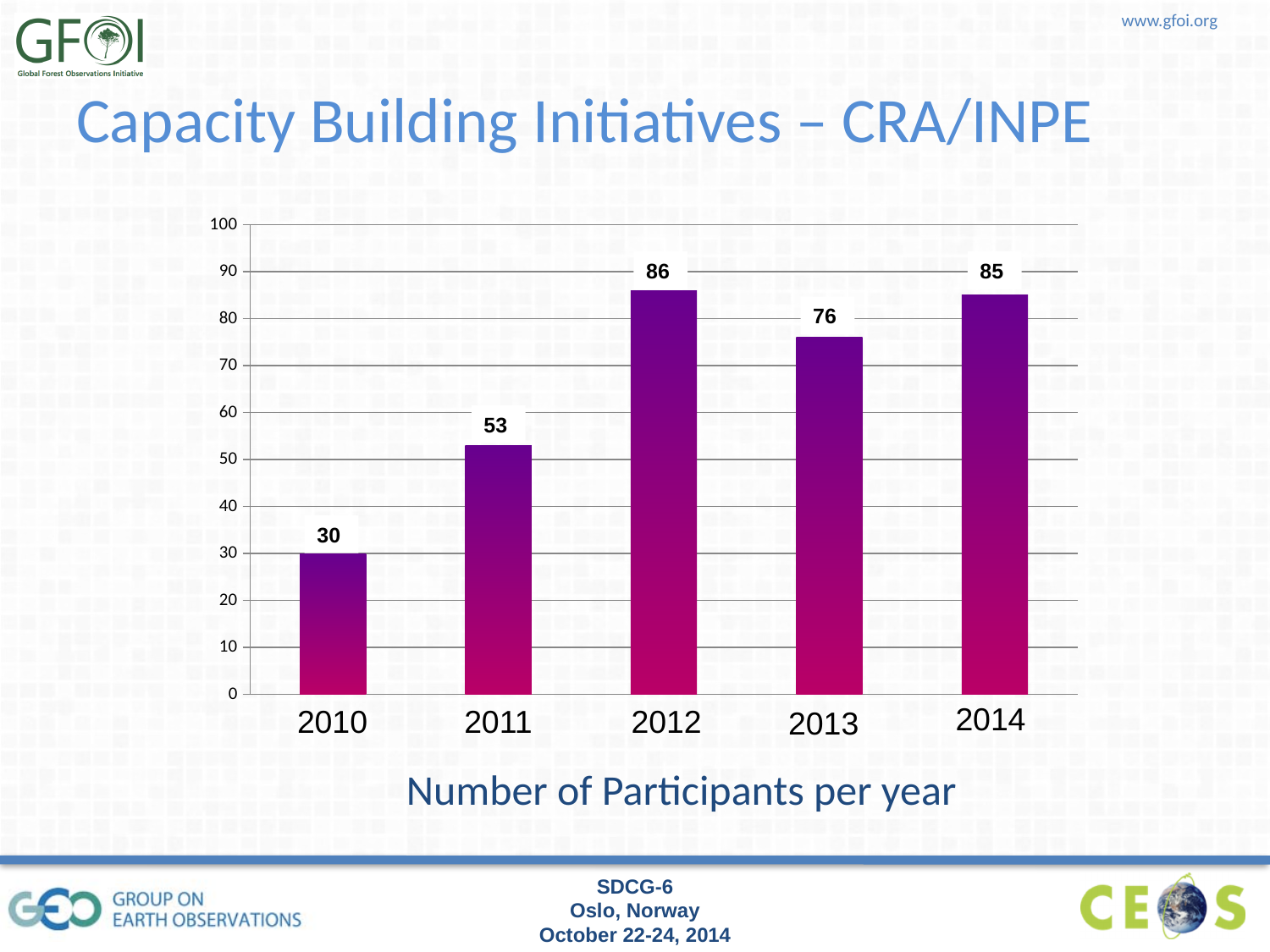
What kind of chart is shown on the slide? Bar chart What is the number of participants in 2013? 76 Is the value for 2011 greater or less than 50? greater What is the caption shown below the chart? Number of Participants per year Which year has the highest number of participants? 2012 Which year has the lowest number of participants? 2010 What is the number of participants in 2012? 86 What is the difference in participants between 2014 and 2013? 9 What is the difference in participants between 2012 and 2010? 56 What is the number of participants in 2010? 30 Which year had more participants, 2011 or 2013? 2013 How many years are shown on the chart? 5